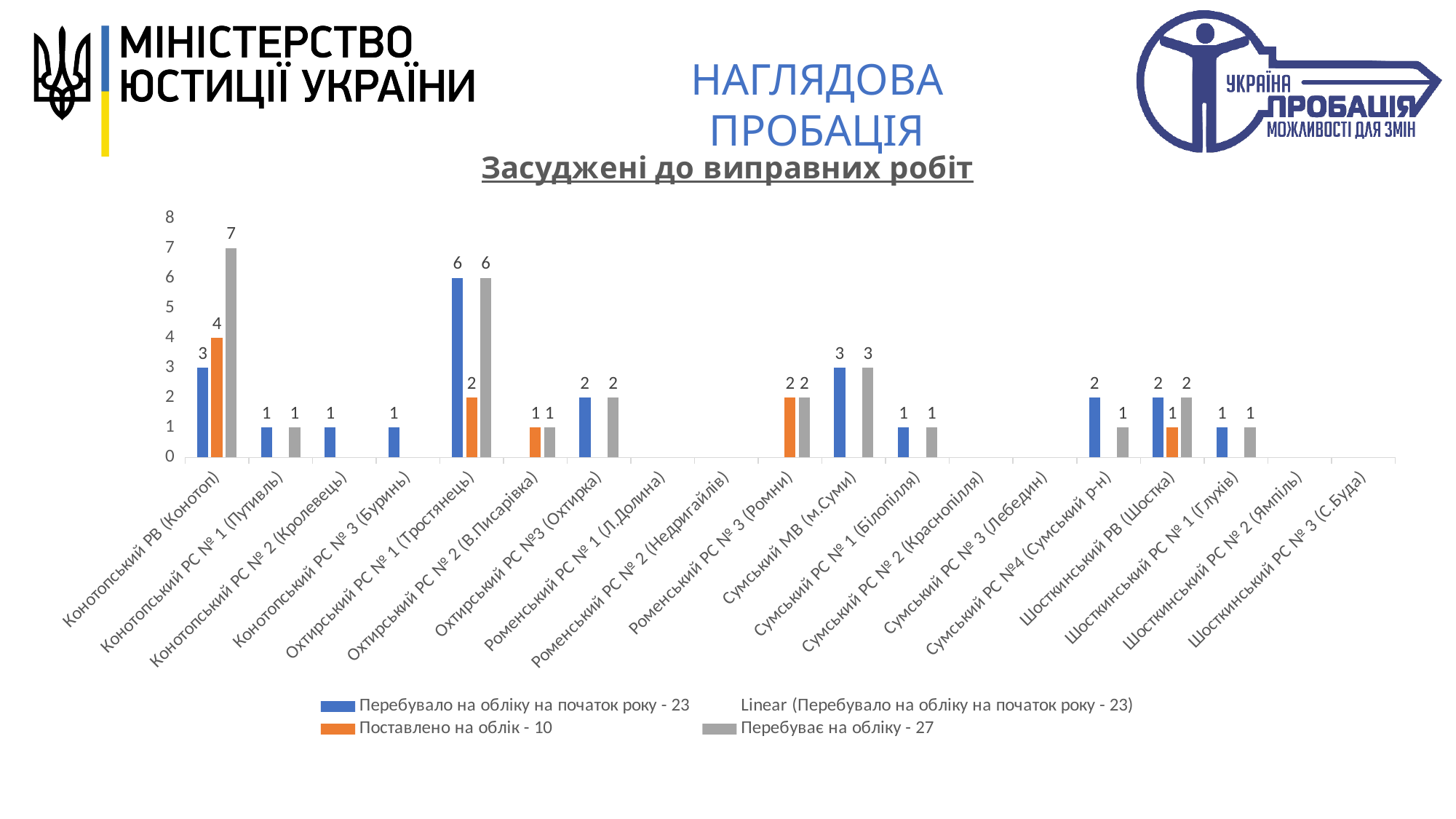
How many categories are shown on the x axis of the chart? 19 What is the difference between the 'Перебуває на обліку - 27' value and the 'Перебувало на обліку на початок року - 23' value for Конотопський РВ (Конотоп)? 4 What is the value of 'Перебувало на обліку на початок року - 23' for Охтирський РС № 1 (Тростянець)? 6 What is the value of 'Поставлено на облік - 10' for Роменський РС № 3 (Ромни)? 2 What is the value of 'Перебуває на обліку - 27' for Сумський МВ (м.Суми)? 3 What type of chart is shown on the slide? bar chart What is the title of the chart? Засуджені до виправних робіт Which is larger for Сумський РС №4 (Сумський р-н): 'Перебувало на обліку на початок року - 23' or 'Перебуває на обліку - 27'? Перебувало на обліку на початок року - 23 How many entries does the chart legend list? 4 Which category has the highest value for 'Перебуває на обліку - 27'? Конотопський РВ (Конотоп) What is the value of 'Поставлено на облік - 10' for Конотопський РВ (Конотоп)? 4 What is the value of 'Перебуває на обліку - 27' for Конотопський РВ (Конотоп)? 7